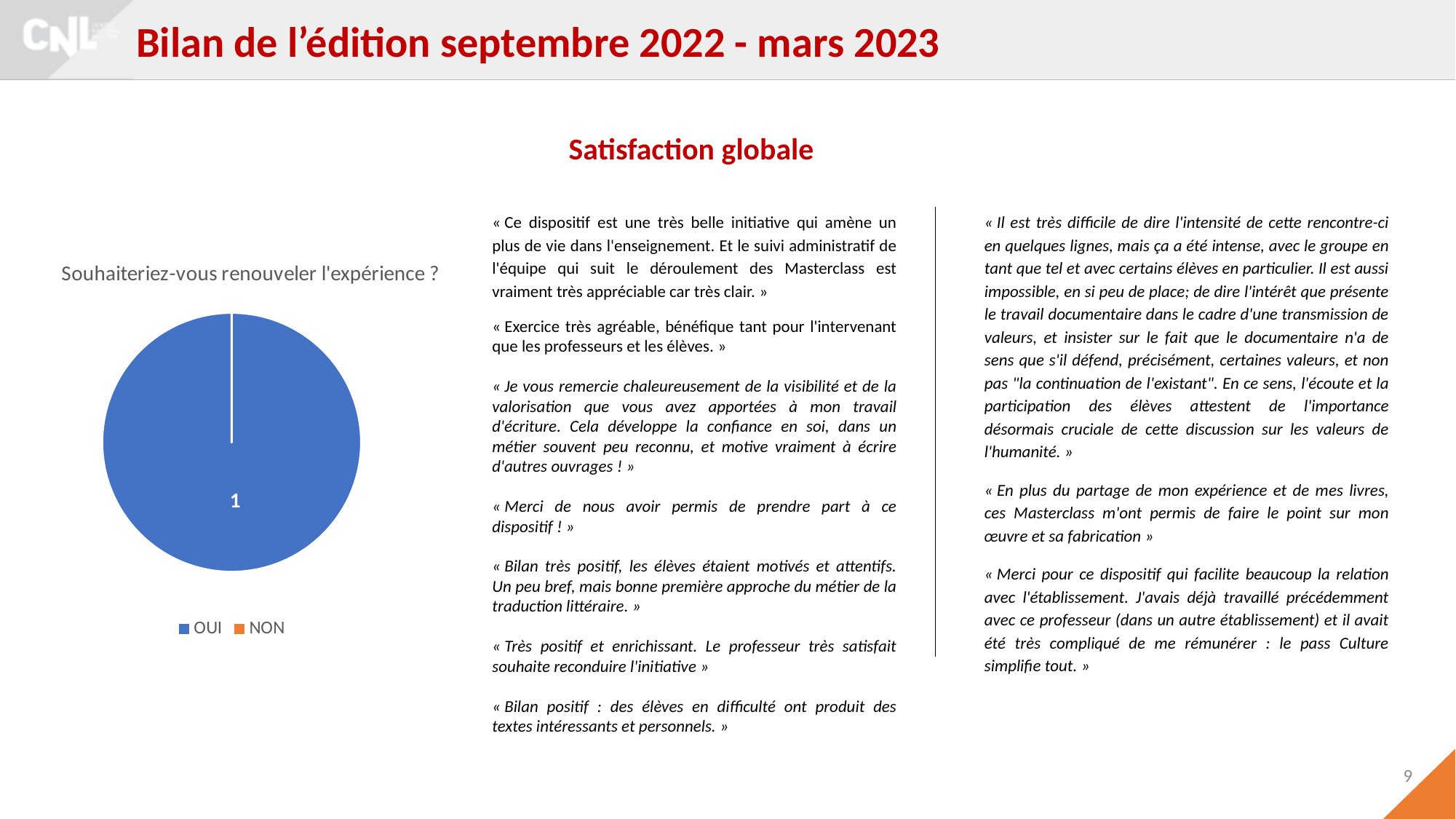
What type of chart is shown on the slide? pie chart How many entries does the legend of the pie chart list? 2 What share of the pie does the OUI slice occupy? 100% Which is larger in the pie chart, OUI or NON? OUI What is the title of the pie chart? Souhaiteriez-vous renouveler l'expérience ? What colour represents OUI in the pie chart legend? blue Which category has the largest slice in the pie chart? OUI Which category has the smallest slice in the pie chart? NON What value is printed on the OUI slice of the pie chart? 1